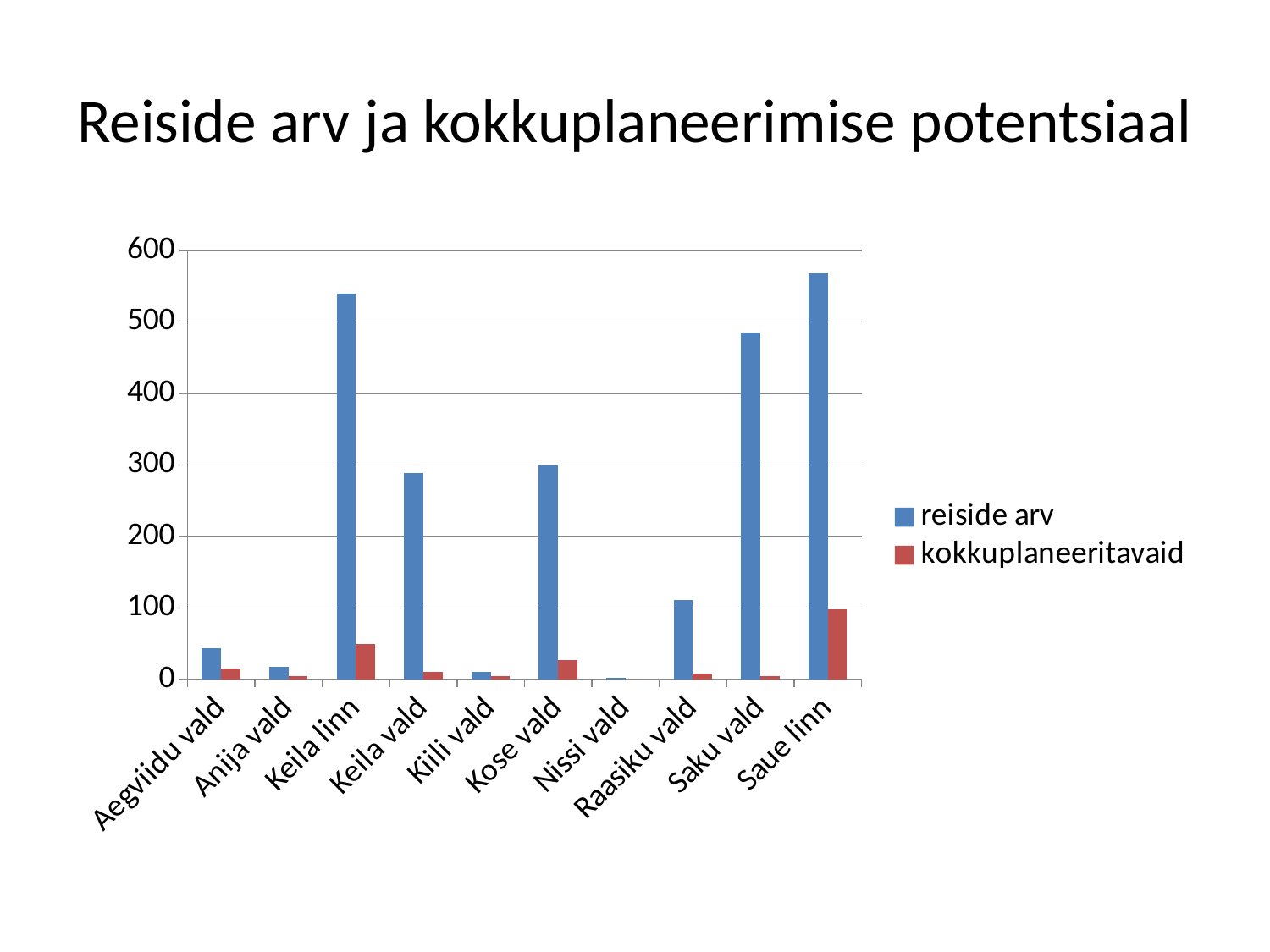
Is the reiside arv value for Keila linn greater or less than 500? greater Is the reiside arv value for Saku vald greater or less than 500? less What kind of chart is shown on the slide? bar chart Which category has the highest value for kokkuplaneeritavaid? Saue linn Is the kokkuplaneeritavaid value for Keila linn greater or less than 100? less Which category has the highest value for reiside arv? Saue linn How many series does the legend list? 2 How many categories are shown on the x axis? 10 Which is larger, the reiside arv value for Keila linn or for Saku vald? Keila linn Which category has the lowest value for reiside arv? Nissi vald What is the title of the chart slide? Reiside arv ja kokkuplaneerimise potentsiaal